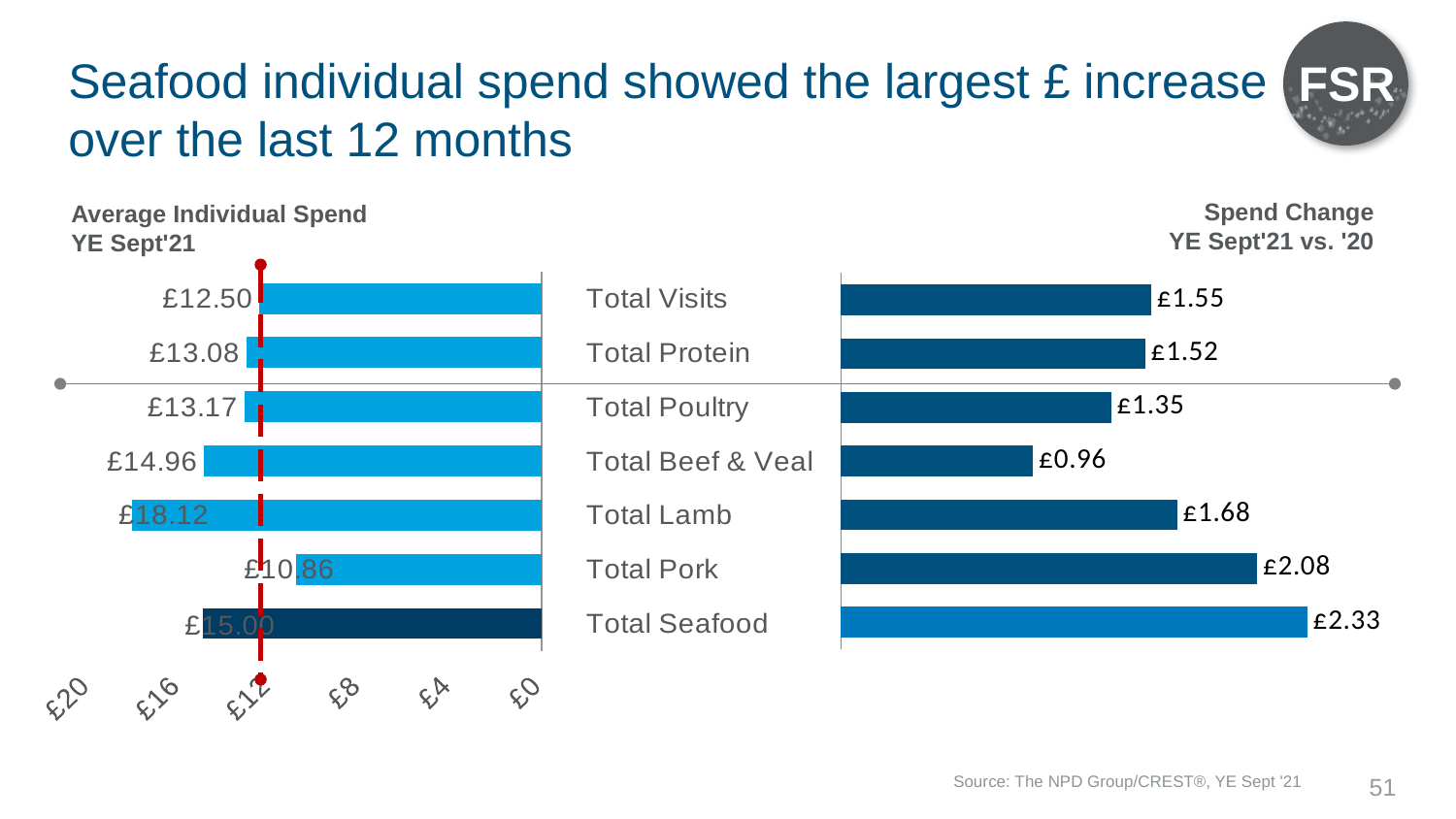
In the Spend Change YE Sept'21 vs. '20 chart, which category has the lowest value? Total Beef & Veal In the Spend Change YE Sept'21 vs. '20 chart, what is the value for Total Beef & Veal? £0.96 In the Spend Change YE Sept'21 vs. '20 chart, what is the difference between Total Seafood and Total Pork? £0.25 In the Average Individual Spend YE Sept'21 chart, what is the value for Total Lamb? £18.12 In the Average Individual Spend YE Sept'21 chart, which category has the highest value? Total Lamb In the Average Individual Spend YE Sept'21 chart, what is the value for Total Pork? £10.86 In the Average Individual Spend YE Sept'21 chart, what is the difference between Total Poultry and Total Protein? £0.09 In the Average Individual Spend YE Sept'21 chart, which is larger, Total Seafood or Total Beef & Veal? Total Seafood In the Spend Change YE Sept'21 vs. '20 chart, what is the value for Total Seafood? £2.33 How many categories are shown in the Spend Change YE Sept'21 vs. '20 chart? 7 What kind of chart is the Average Individual Spend YE Sept'21 chart? Bar chart In the Average Individual Spend YE Sept'21 chart, which category has the lowest value? Total Pork